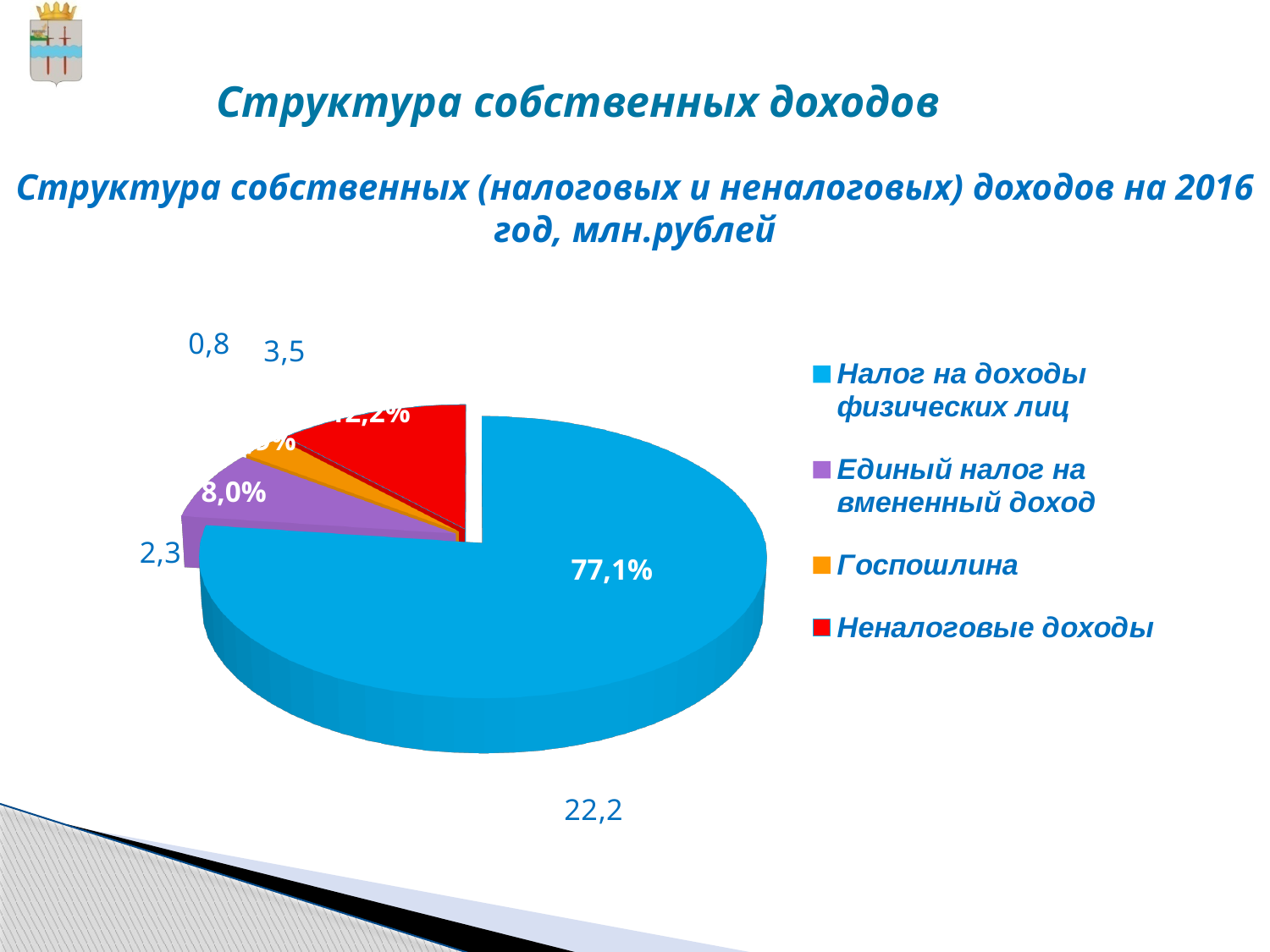
What is the difference between the value for Налог на доходы физических лиц (22,2) and the value for Единый налог на вмененный доход (2,3)? 19,9 What share of the pie does Единый налог на вмененный доход have? 8,0% Which category has the largest slice of the pie? Налог на доходы физических лиц How many categories does the legend of the pie chart list? 4 What share of the pie does Налог на доходы физических лиц have? 77,1% What kind of chart is shown on the slide? pie chart What is the value (млн.рублей) shown for Неналоговые доходы? 3,5 What is the value (млн.рублей) shown for Госпошлина? 0,8 Which is larger: the value for Неналоговые доходы or the value for Единый налог на вмененный доход? Неналоговые доходы Which category has the smallest slice of the pie? Госпошлина What is the value (млн.рублей) shown for Налог на доходы физических лиц? 22,2 What colour is the Госпошлина slice in the pie chart? orange